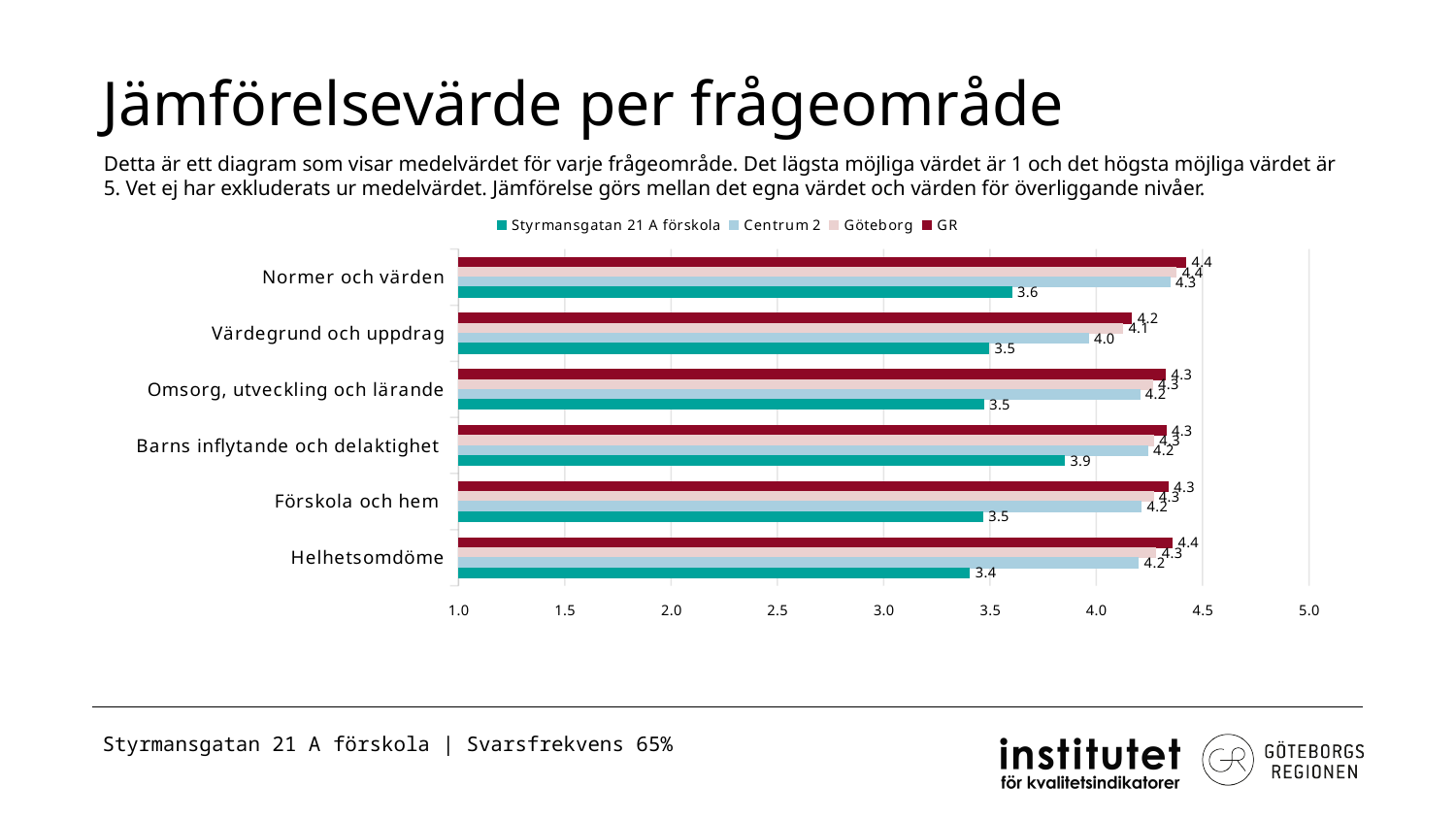
Is the value for Styrmansgatan 21 A förskola in Förskola och hem greater or less than 4.0? less What is the value for Centrum 2 in the category Värdegrund och uppdrag? 4.0 How many series does the legend list? 4 What is the value for Styrmansgatan 21 A förskola in the category Barns inflytande och delaktighet? 3.9 Which category has the highest value for Styrmansgatan 21 A förskola? Barns inflytande och delaktighet In the category Normer och värden, which is larger: the value for GR or the value for Styrmansgatan 21 A förskola? GR What kind of chart is shown on the slide? Bar chart What is the value for GR in the category Helhetsomdöme? 4.4 How many categories are shown on the y axis of the chart? 6 Which category has the lowest value for Styrmansgatan 21 A förskola? Helhetsomdöme What is the value for Styrmansgatan 21 A förskola in the category Normer och värden? 3.6 What is the difference between the GR value and the Styrmansgatan 21 A förskola value in the category Helhetsomdöme? 1.0